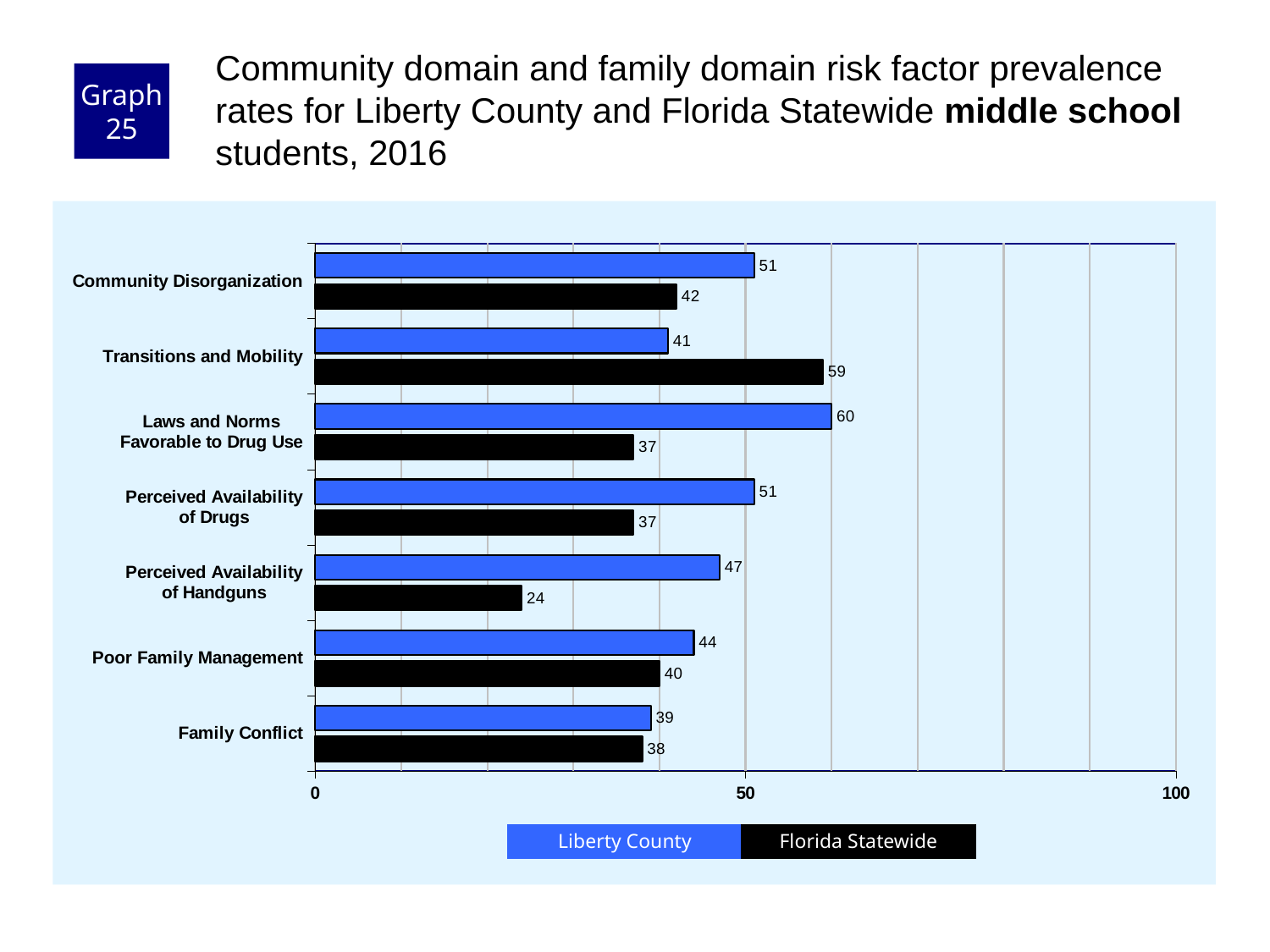
What is the Florida Statewide value for Perceived Availability of Handguns? 24 What is the difference between the Liberty County and Florida Statewide values for Perceived Availability of Handguns? 23 What kind of chart is shown on the slide? Bar chart Is the Liberty County value for Community Disorganization greater or less than 50? greater How many series does the legend list? 2 What is the Florida Statewide value for Transitions and Mobility? 59 Which risk factor has the highest Liberty County value? Laws and Norms Favorable to Drug Use Which is larger for Transitions and Mobility: the Liberty County value or the Florida Statewide value? Florida Statewide Which colour represents Florida Statewide in the legend? Black How many risk factors are shown on the chart? 7 What is the Liberty County value for Laws and Norms Favorable to Drug Use? 60 Which risk factor has the lowest Florida Statewide value? Perceived Availability of Handguns